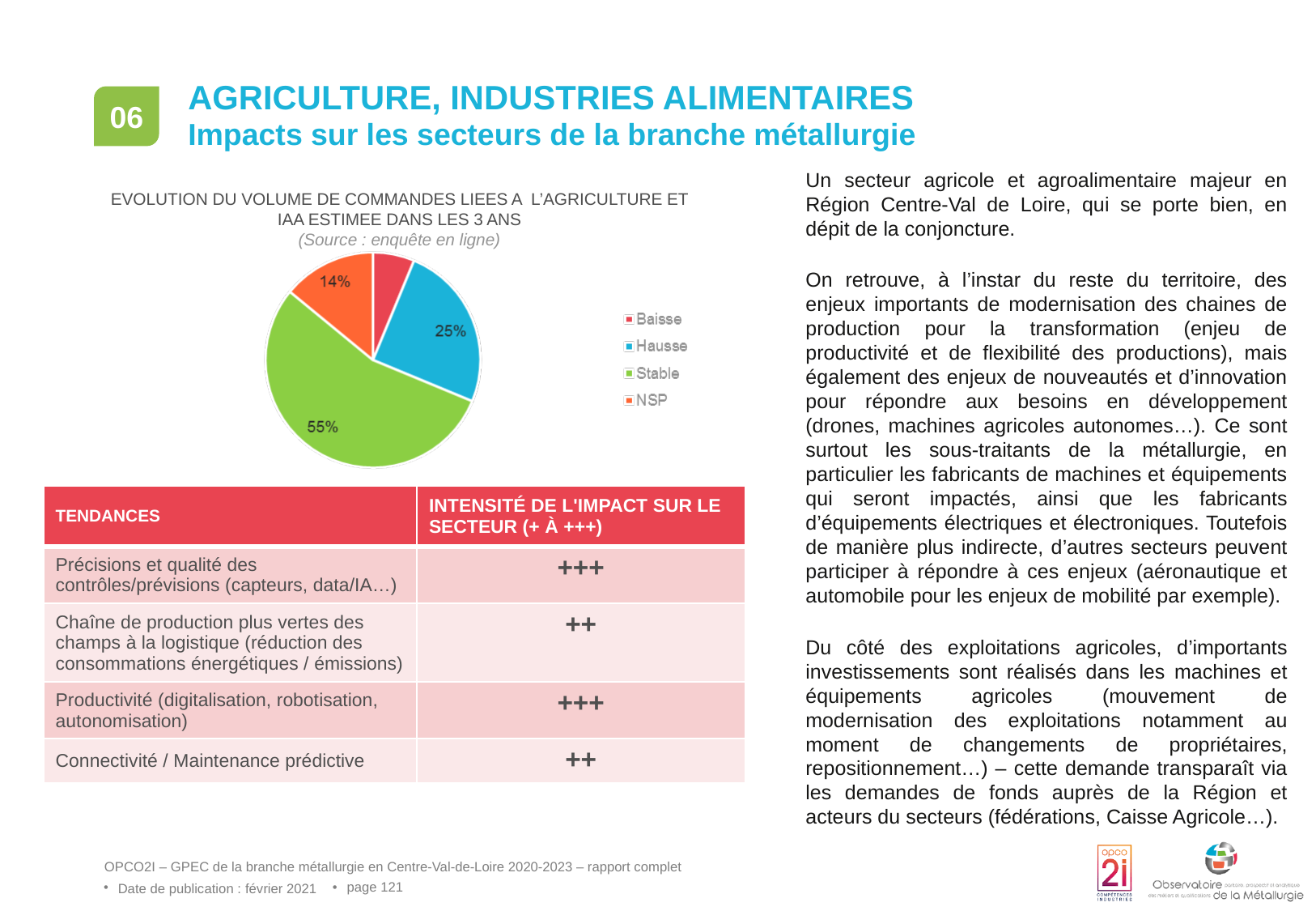
What percentage of the pie chart corresponds to Stable? 55% Which category has the largest share of the pie chart? Stable What percentage of the pie chart corresponds to NSP? 14% What is the source given under the chart title? enquête en ligne What is the difference in percentage points between Hausse and NSP? 11 What colour is the Stable slice in the pie chart? green What type of chart is shown on the slide? pie chart Which category has the smallest share of the pie chart? Baisse How many categories does the legend of the pie chart list? 4 What is the difference in percentage points between Stable and Hausse? 30 What percentage of the pie chart corresponds to Hausse? 25% Which is larger, the share for Hausse or the share for NSP? Hausse